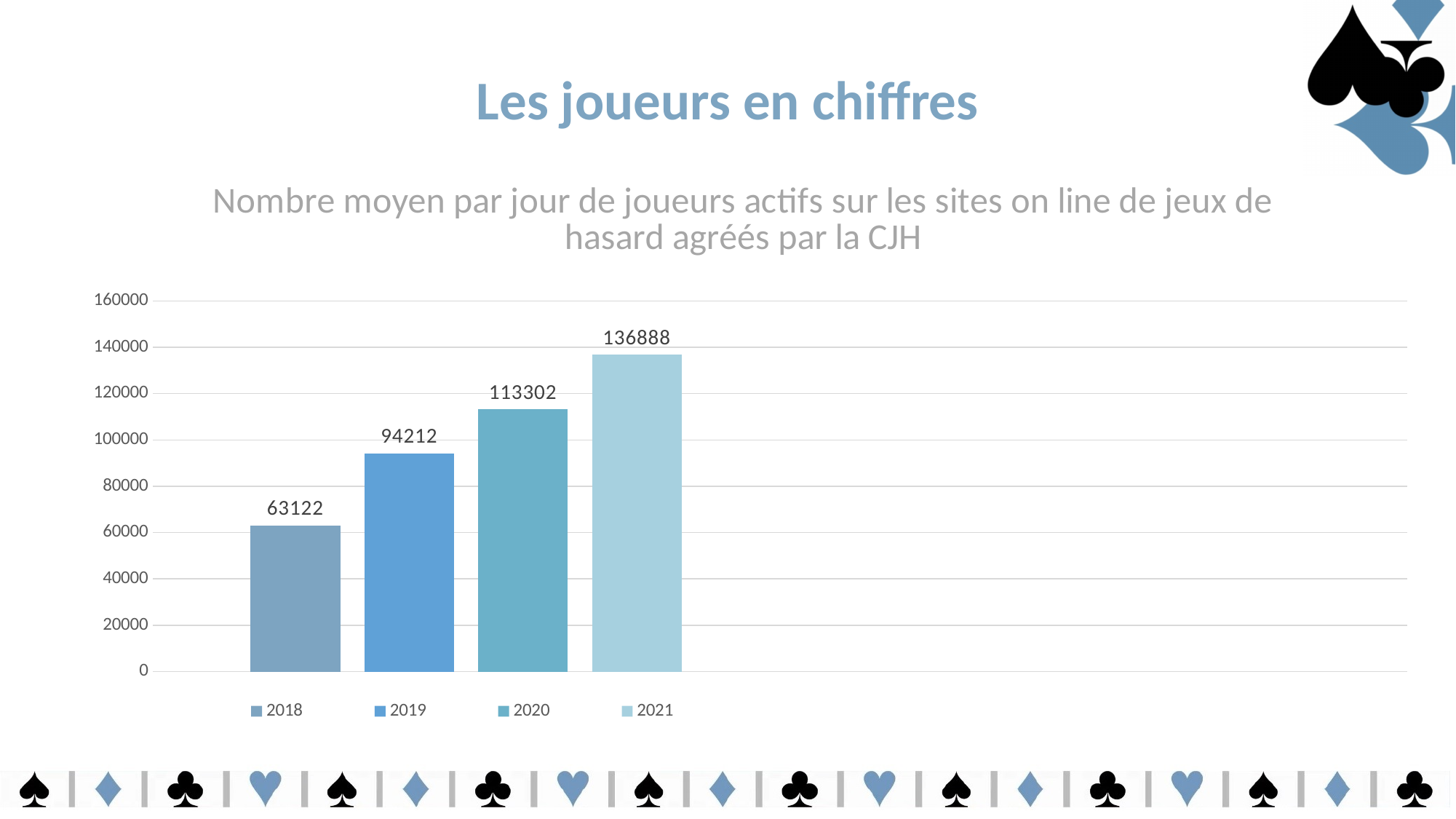
What kind of chart is shown on the slide? bar chart Which is larger, the value for 2019 or the value for 2020? 2020 How many bars are plotted in the chart? 4 What is the difference between the values for 2021 and 2018? 73766 Is the value for 2019 greater or less than 100000? less What is the average number of daily active players for 2018? 63122 What is the difference between the values for 2020 and 2019? 19090 Do the values rise or fall from 2018 to 2021? rise Which year has the highest value? 2021 What is the value shown for 2020? 113302 What is the value shown for 2021? 136888 Which year has the lowest value? 2018